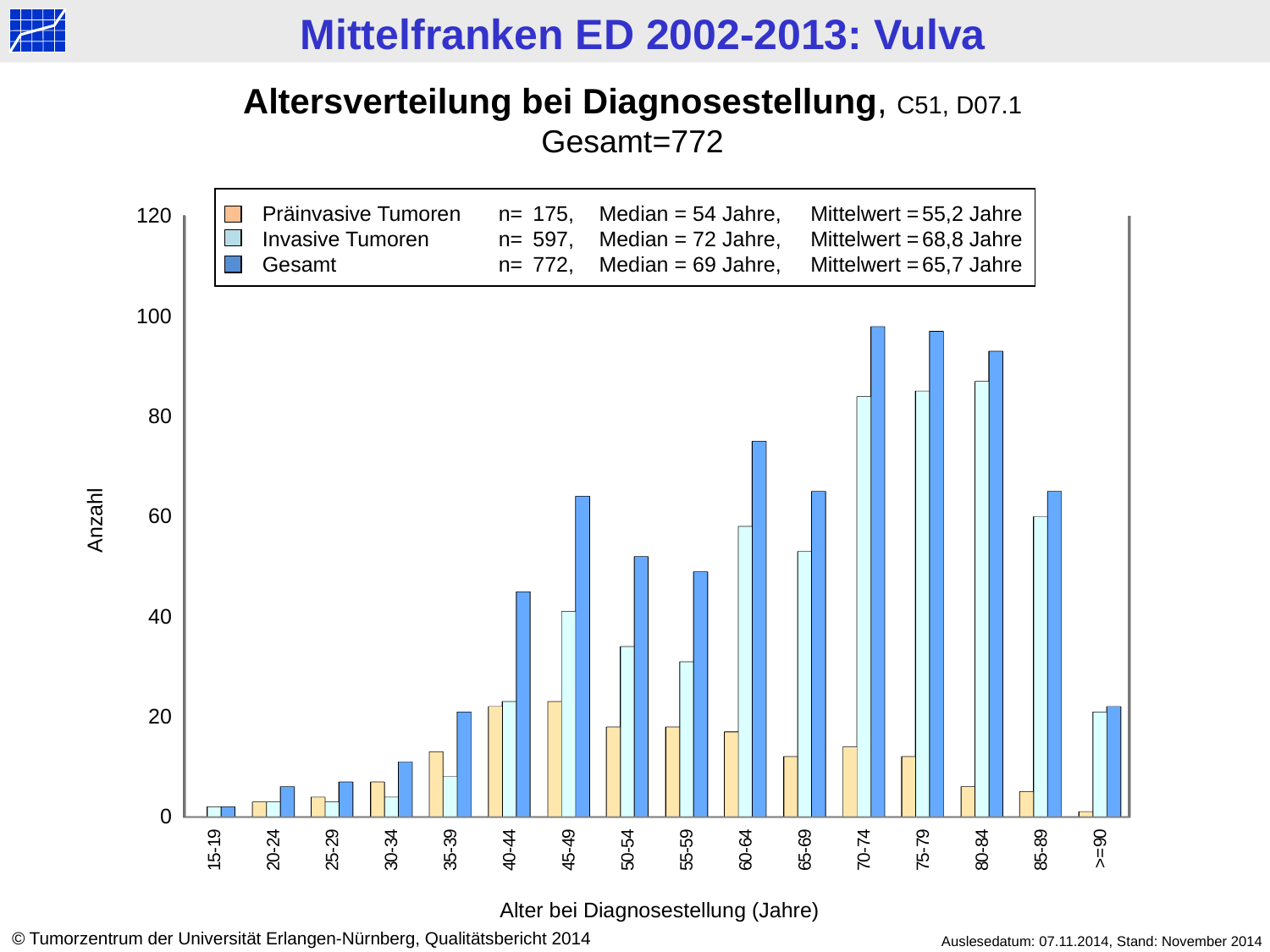
Is the Gesamt value for the 70-74 age group greater or less than 80? greater What kind of chart is shown on the slide? bar chart Which age group has the lowest Gesamt value? 15-19 Which is larger, the Gesamt value for 60-64 or for 65-69? 60-64 Is the Gesamt value for the 40-44 age group greater or less than 40? greater How many age groups are shown on the x axis? 16 According to the legend, what is the Mittelwert for Präinvasive Tumoren? 55,2 Jahre According to the legend, what is the median age for Gesamt? 69 Jahre According to the legend, what is n for Invasive Tumoren? 597 How many series does the legend list? 3 Is the Invasive Tumoren value for the 50-54 age group greater or less than 40? less Do the Gesamt values rise or fall from the 15-19 age group to the 70-74 age group? rise